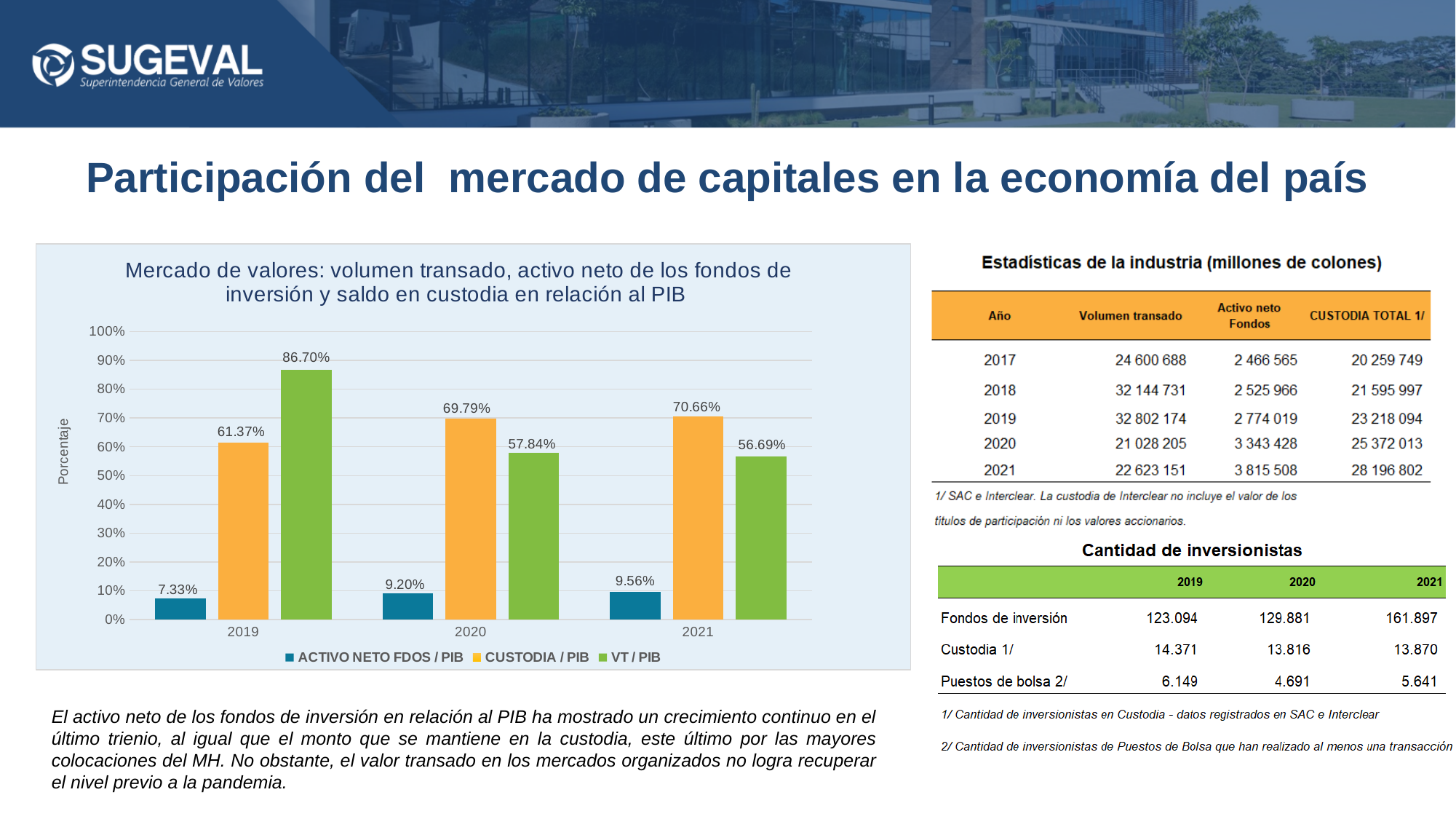
How many series does the legend list? 3 In which year is ACTIVO NETO FDOS / PIB lowest? 2019 What is the difference between ACTIVO NETO FDOS / PIB in 2021 and in 2019? 2.23% What is the value of VT / PIB for 2019? 86.70% What type of chart is shown on the slide? Bar chart What is the difference between VT / PIB in 2019 and VT / PIB in 2020? 28.86% What is the value of ACTIVO NETO FDOS / PIB for 2020? 9.20% In which year is VT / PIB highest? 2019 How many years are shown on the x axis? 3 Which is larger in 2021: CUSTODIA / PIB or VT / PIB? CUSTODIA / PIB What is the value of CUSTODIA / PIB for 2021? 70.66% Does CUSTODIA / PIB rise or fall from 2019 to 2021? Rise